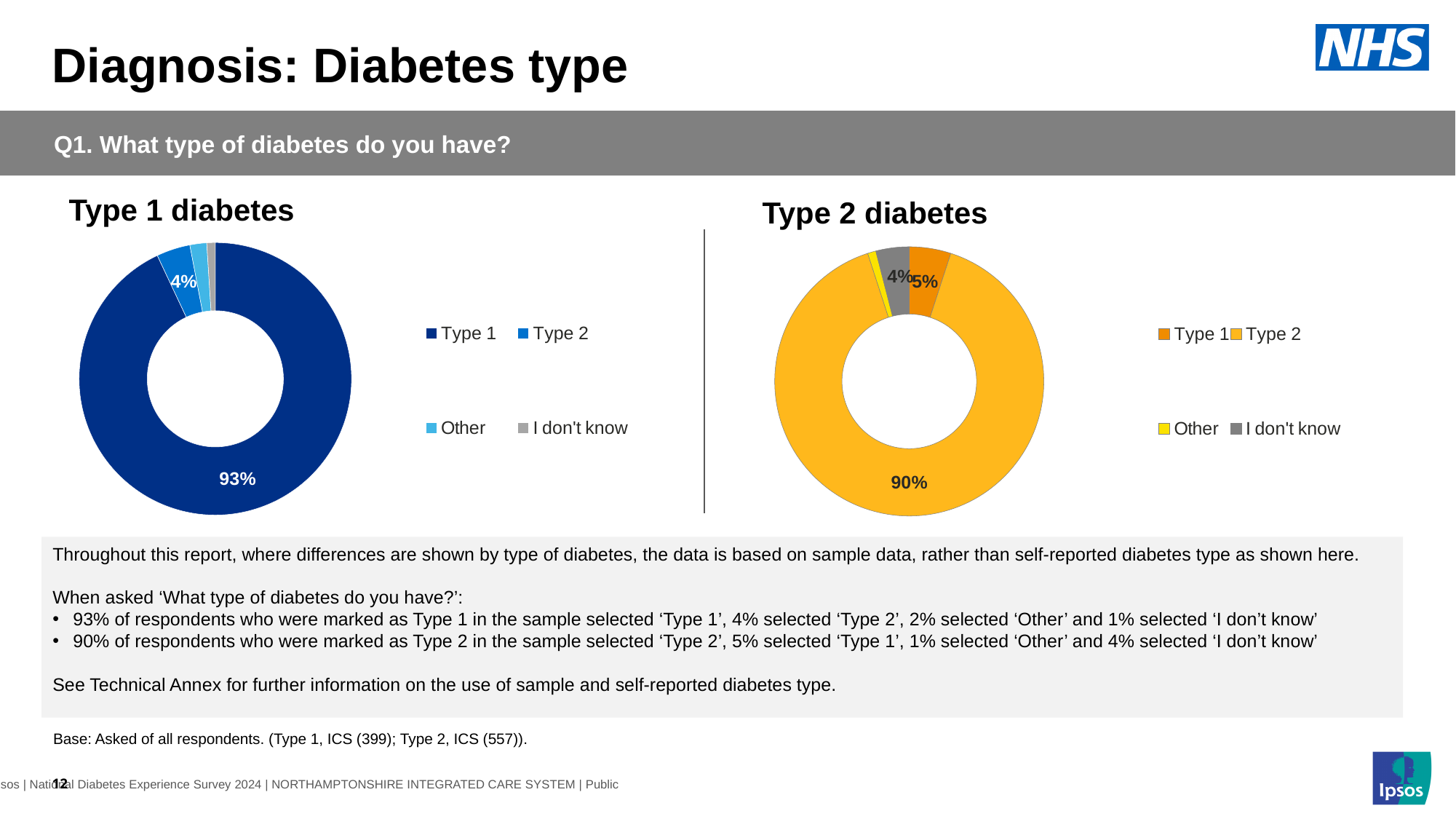
What kind of chart is used for the Type 2 diabetes data? Doughnut (pie) chart In the Type 2 diabetes chart, what percentage of respondents selected 'Type 2'? 90% In the Type 1 diabetes chart, what is the difference in percentage points between the 'Type 1' and 'Type 2' slices? 89 percentage points In the Type 2 diabetes chart, which category has the smallest slice? Other In the Type 2 diabetes chart, what percentage of respondents selected 'I don't know'? 4% In the Type 2 diabetes chart, which category has the largest slice? Type 2 In the Type 2 diabetes chart, which is larger, the 'Type 1' slice or the 'I don't know' slice? Type 1 In the Type 1 diabetes chart, what percentage of respondents selected 'Type 1'? 93% How many categories does the legend of the Type 1 diabetes chart list? 4 In the Type 1 diabetes chart, which category has the largest slice? Type 1 In the Type 2 diabetes chart, what percentage of respondents selected 'Type 1'? 5% In the Type 1 diabetes chart, what percentage of respondents selected 'Type 2'? 4%